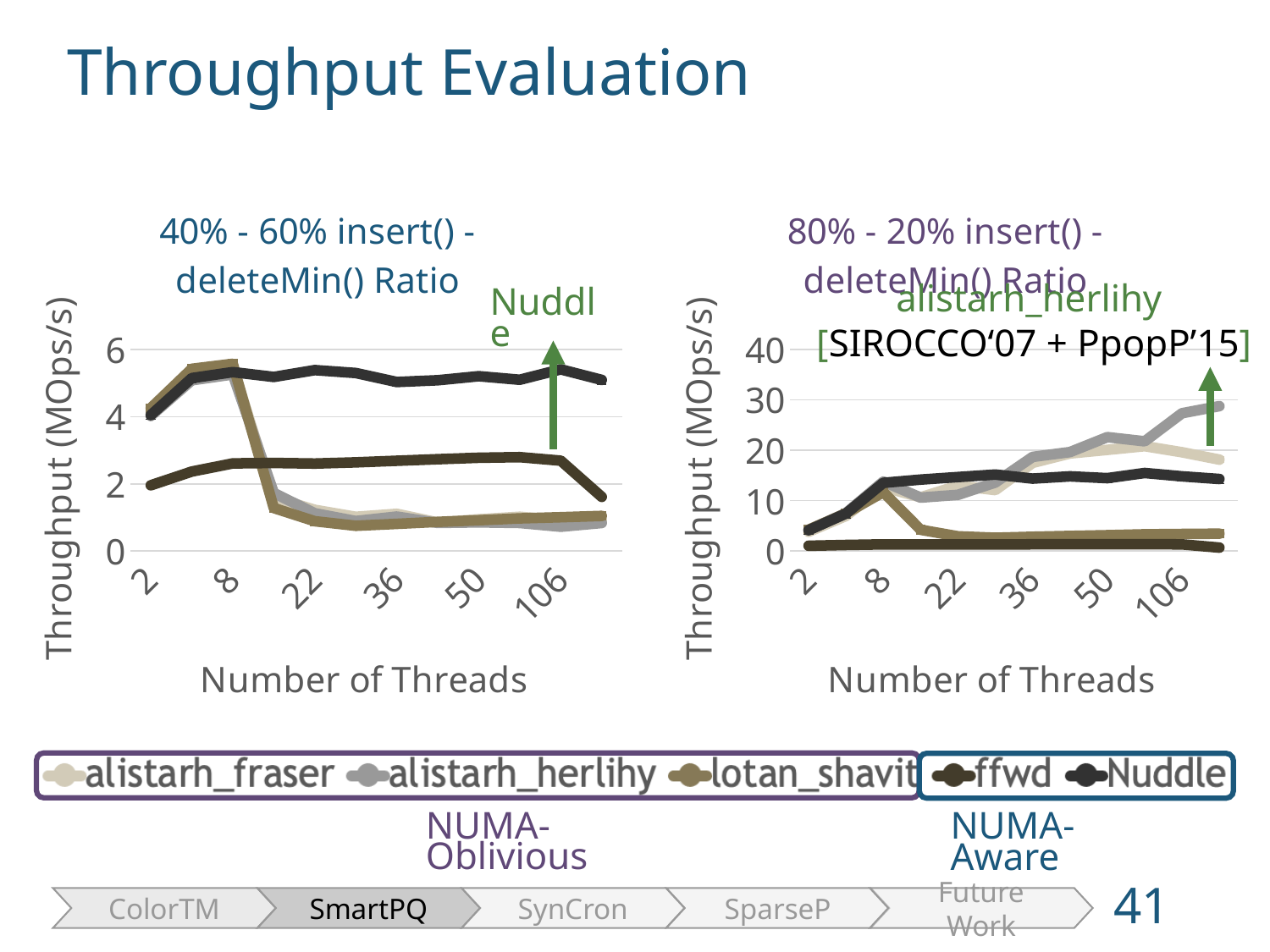
In the left chart (40% - 60% insert() - deleteMin() Ratio), is the value for Nuddle at 106 threads greater or less than 4? greater In the right chart (80% - 20% insert() - deleteMin() Ratio), is the value for alistarh_herlihy at 106 threads greater or less than 20? greater How many series does the legend at the bottom of the slide list? 5 In the right chart (80% - 20% insert() - deleteMin() Ratio), is the value for ffwd at 106 threads greater or less than 10? less In the right chart (80% - 20% insert() - deleteMin() Ratio), does the alistarh_herlihy line generally rise or fall as the number of threads increases? rise In the left chart (40% - 60% insert() - deleteMin() Ratio), which is larger at 106 threads: Nuddle or ffwd? Nuddle What is the label of the y-axis on both charts? Throughput (MOps/s) In the right chart (80% - 20% insert() - deleteMin() Ratio), which is larger at 106 threads: alistarh_herlihy or Nuddle? alistarh_herlihy What kind of chart is the left chart titled '40% - 60% insert() - deleteMin() Ratio'? line chart